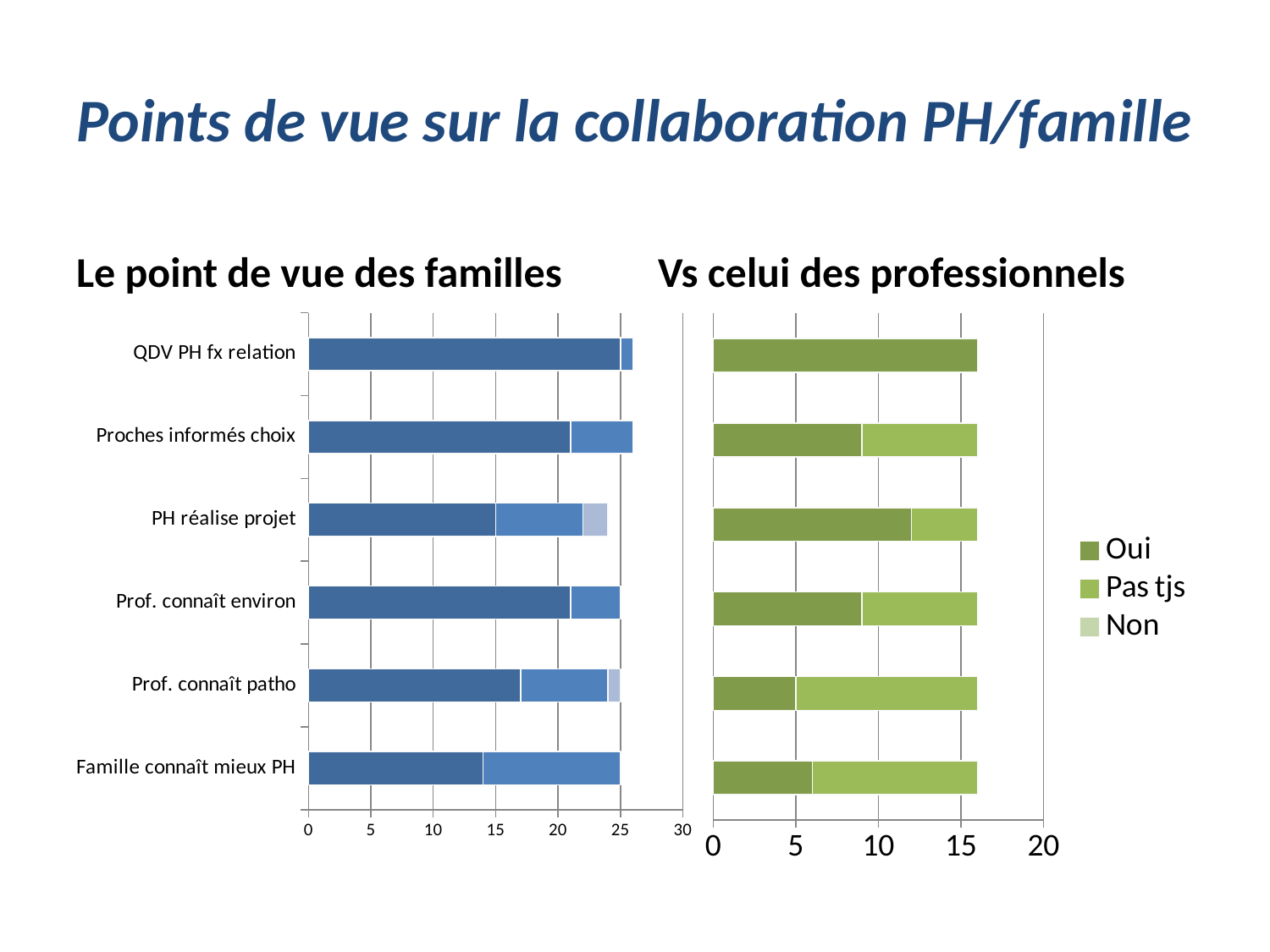
What kind of chart is 'Le point de vue des familles'? bar chart What are the three entries in the legend? Oui, Pas tjs, Non In the 'Vs celui des professionnels' chart, which has the larger 'Oui' value: PH réalise projet or Prof. connaît patho? PH réalise projet In the 'Le point de vue des familles' chart, is the 'Oui' value for QDV PH fx relation greater or less than 20? greater How many categories does the 'Vs celui des professionnels' chart show? 6 In the 'Vs celui des professionnels' chart, which category has the largest 'Oui' value? QDV PH fx relation How many series does the legend list? 3 In the 'Le point de vue des familles' chart, which has the larger 'Oui' value: QDV PH fx relation or Famille connaît mieux PH? QDV PH fx relation In the 'Le point de vue des familles' chart, is the 'Oui' value for Famille connaît mieux PH greater or less than 15? less What is the title of the slide? Points de vue sur la collaboration PH/famille In the 'Vs celui des professionnels' chart, is the 'Oui' value for Prof. connaît patho greater or less than 10? less